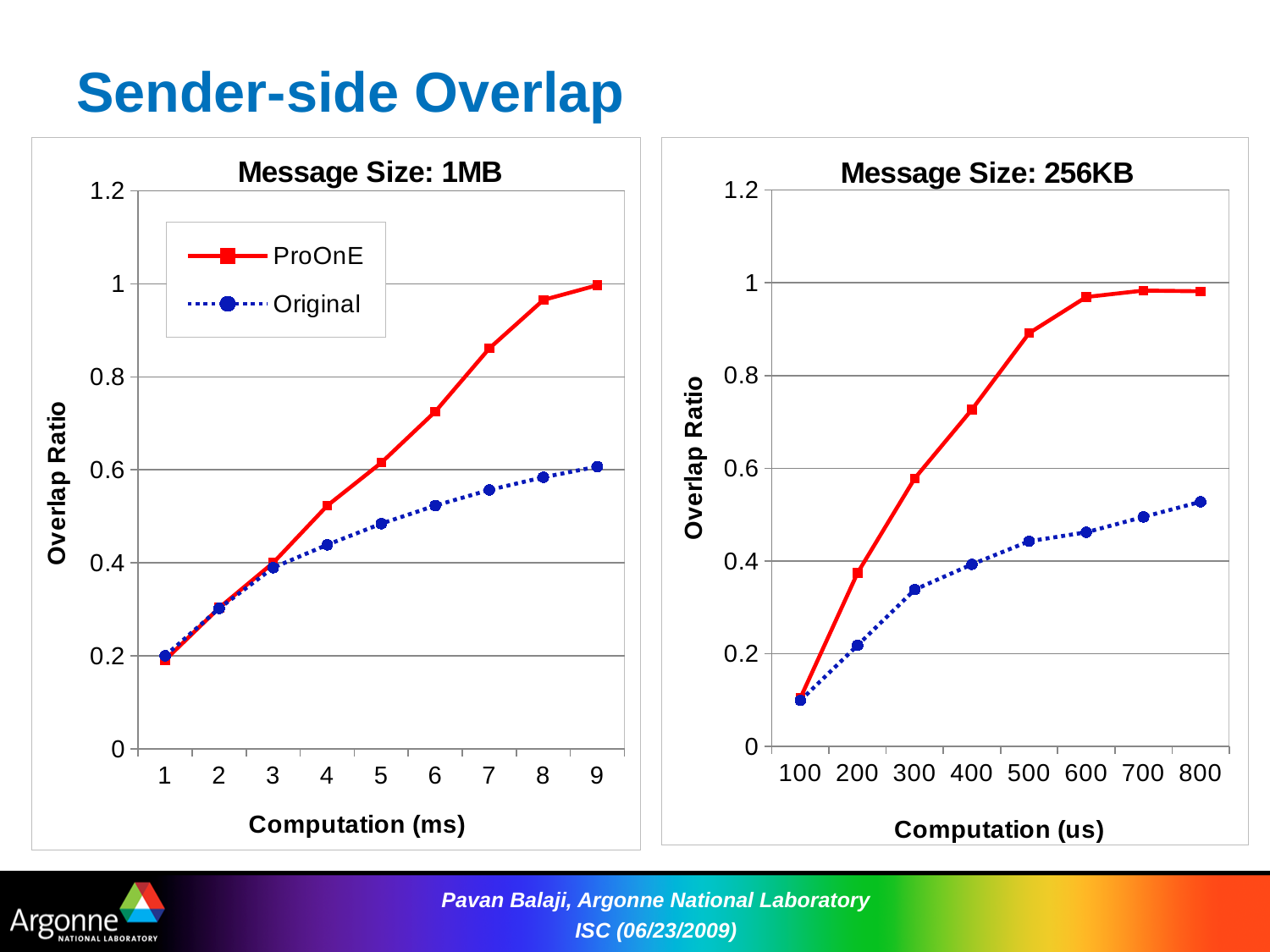
In the "Message Size: 256KB" chart, which series has the higher overlap ratio at 800 us, ProOnE or Original? ProOnE In the "Message Size: 1MB" chart, which series has the higher overlap ratio at 9 ms, ProOnE or Original? ProOnE In the "Message Size: 256KB" chart, is the ProOnE overlap ratio at 100 us greater or less than 0.2? less How many computation values are plotted along the x axis of the "Message Size: 256KB" chart? 8 In the "Message Size: 256KB" chart, is the ProOnE overlap ratio at 800 us greater or less than 0.8? greater In the "Message Size: 1MB" chart, is the ProOnE overlap ratio at 9 ms greater or less than 0.8? greater What type of chart is the "Message Size: 1MB" chart? line chart In the "Message Size: 256KB" chart, does the ProOnE overlap ratio rise or fall as computation increases from 100 us to 600 us? rise What is the y-axis label of the "Message Size: 1MB" chart? Overlap Ratio How many computation values are plotted along the x axis of the "Message Size: 1MB" chart? 9 How many series does the legend list on the "Message Size: 1MB" chart? 2